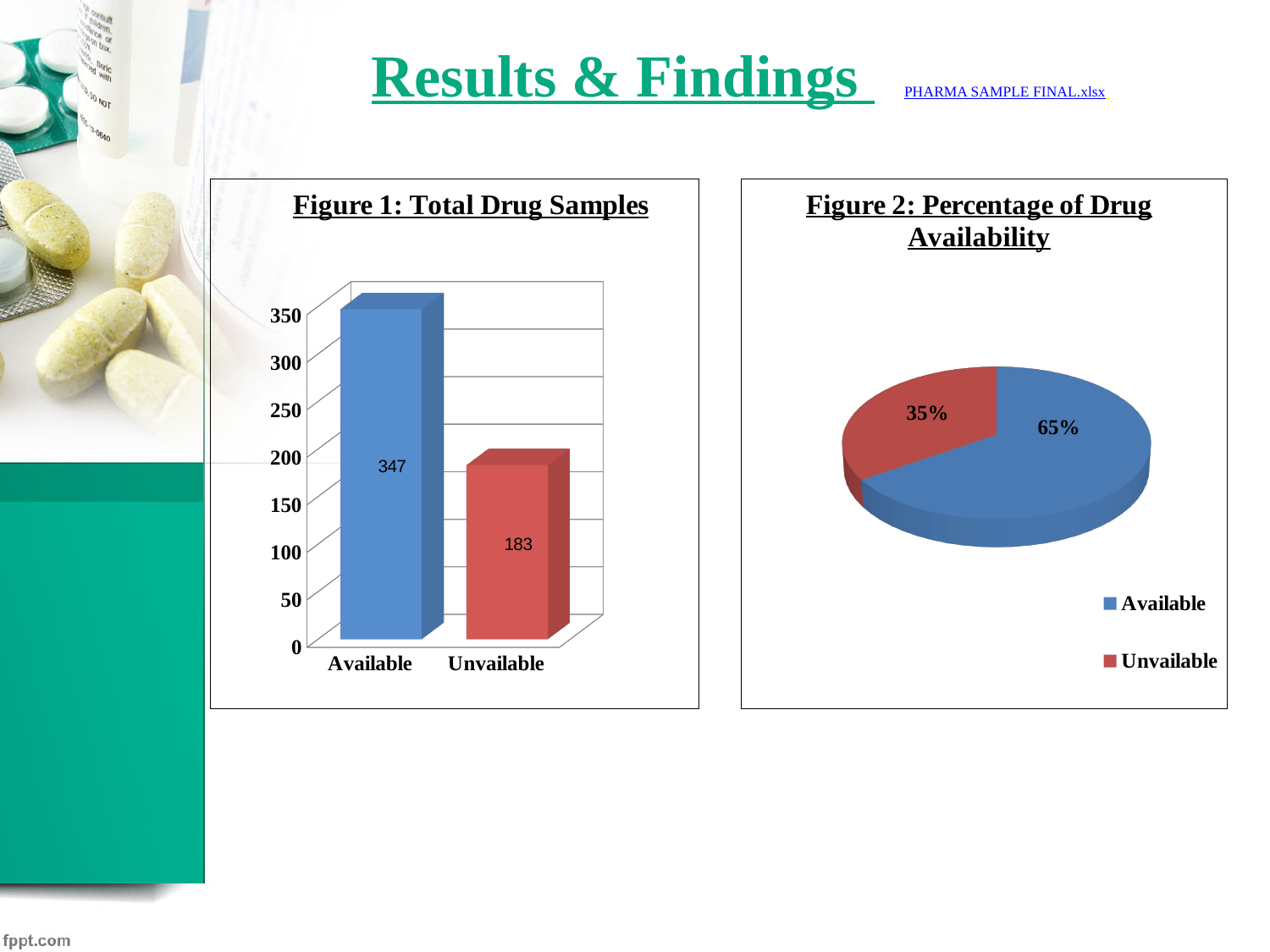
In Figure 2: Percentage of Drug Availability, how many entries does the legend list? 2 In Figure 1: Total Drug Samples, how many categories are shown on the x axis? 2 In Figure 2: Percentage of Drug Availability, which slice is larger, Available or Unavailable? Available In Figure 1: Total Drug Samples, what is the value for Available? 347 In Figure 1: Total Drug Samples, what is the value for Unavailable? 183 In Figure 1: Total Drug Samples, what is the difference between the Available and Unavailable values? 164 In Figure 1: Total Drug Samples, which category has the lowest value? Unavailable What kind of chart is Figure 1: Total Drug Samples? Bar chart What kind of chart is Figure 2: Percentage of Drug Availability? Pie chart In Figure 2: Percentage of Drug Availability, what share of the pie is Available? 65% In Figure 1: Total Drug Samples, which category has the highest value? Available In Figure 2: Percentage of Drug Availability, what share of the pie is Unavailable? 35%